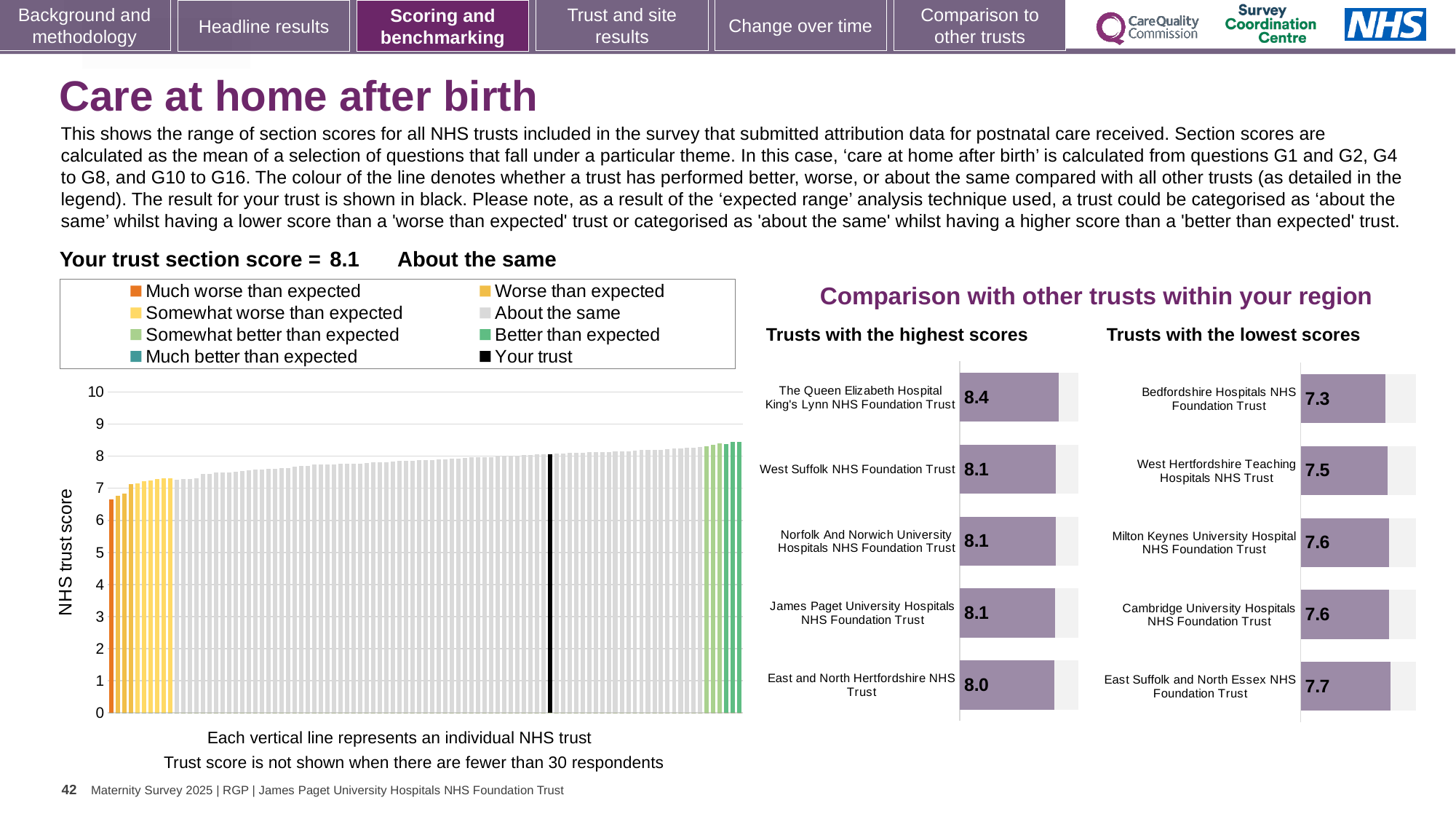
In the 'Trusts with the highest scores' chart, what is the difference between the scores of The Queen Elizabeth Hospital King's Lynn NHS Foundation Trust and East and North Hertfordshire NHS Trust? 0.4 How many trusts are shown in the 'Trusts with the highest scores' chart? 5 In the 'Trusts with the highest scores' chart, what is the score for The Queen Elizabeth Hospital King's Lynn NHS Foundation Trust? 8.4 In the 'Trusts with the lowest scores' chart, which has the higher score: West Hertfordshire Teaching Hospitals NHS Trust or Milton Keynes University Hospital NHS Foundation Trust? Milton Keynes University Hospital NHS Foundation Trust In the 'Trusts with the highest scores' chart, which trust has the highest score? The Queen Elizabeth Hospital King's Lynn NHS Foundation Trust What kind of chart is the large 'NHS trust score' chart on the left of the slide? bar chart In the 'Trusts with the lowest scores' chart, which trust has the lowest score? Bedfordshire Hospitals NHS Foundation Trust In the 'NHS trust score' chart on the left, what is the section score for your trust (the black bar)? 8.1 In the 'Trusts with the lowest scores' chart, what is the score for Bedfordshire Hospitals NHS Foundation Trust? 7.3 In the 'NHS trust score' chart on the left, do the trust scores rise or fall from left to right? rise In the 'NHS trust score' chart on the left, is the value of the black 'Your trust' bar greater or less than 7? greater In the 'Trusts with the lowest scores' chart, what is the difference between the scores of East Suffolk and North Essex NHS Foundation Trust and Bedfordshire Hospitals NHS Foundation Trust? 0.4